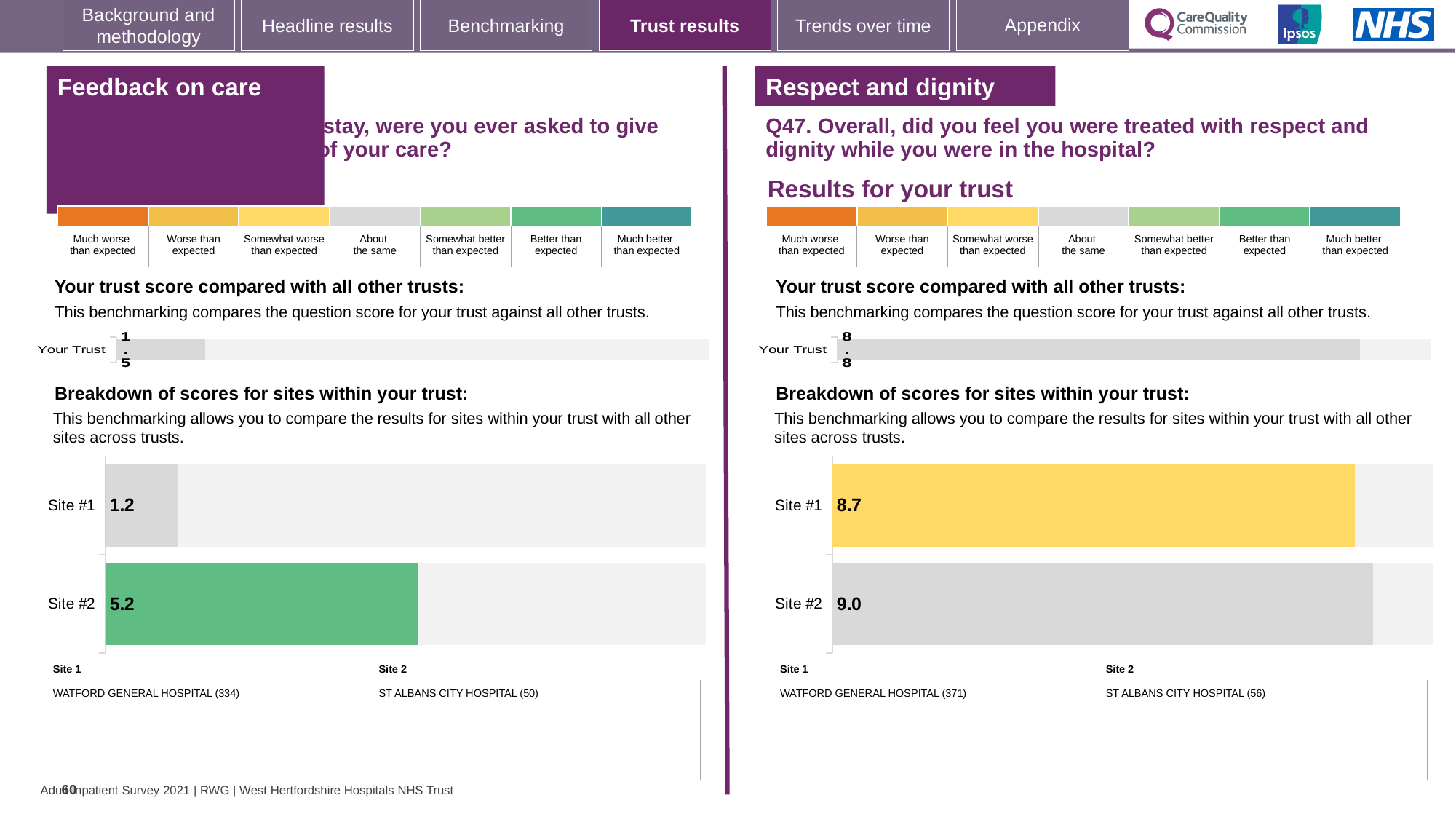
In the 'Respect and dignity' site breakdown chart, what is the score for Site #2? 9.0 In the 'Feedback on care' site breakdown chart, which site has the higher score? Site #2 In the 'Feedback on care' site breakdown chart, what is the score for Site #1? 1.2 In the 'Feedback on care' section, what is the 'Your Trust' score shown in the trust comparison chart? 1.5 In the 'Feedback on care' site breakdown chart, what is the score for Site #2? 5.2 In the 'Respect and dignity' site breakdown chart, which site has the lower score? Site #1 In the 'Respect and dignity' section, what is the 'Your Trust' score shown in the trust comparison chart? 8.8 What type of chart is used for the site breakdown in the 'Respect and dignity' section? Bar chart In the 'Respect and dignity' site breakdown chart, what is the difference between the Site #2 and Site #1 scores? 0.3 How many sites are shown in the 'Feedback on care' site breakdown chart? 2 In the 'Feedback on care' site breakdown chart, what is the difference between the Site #2 and Site #1 scores? 4.0 In the 'Respect and dignity' site breakdown chart, what is the score for Site #1? 8.7